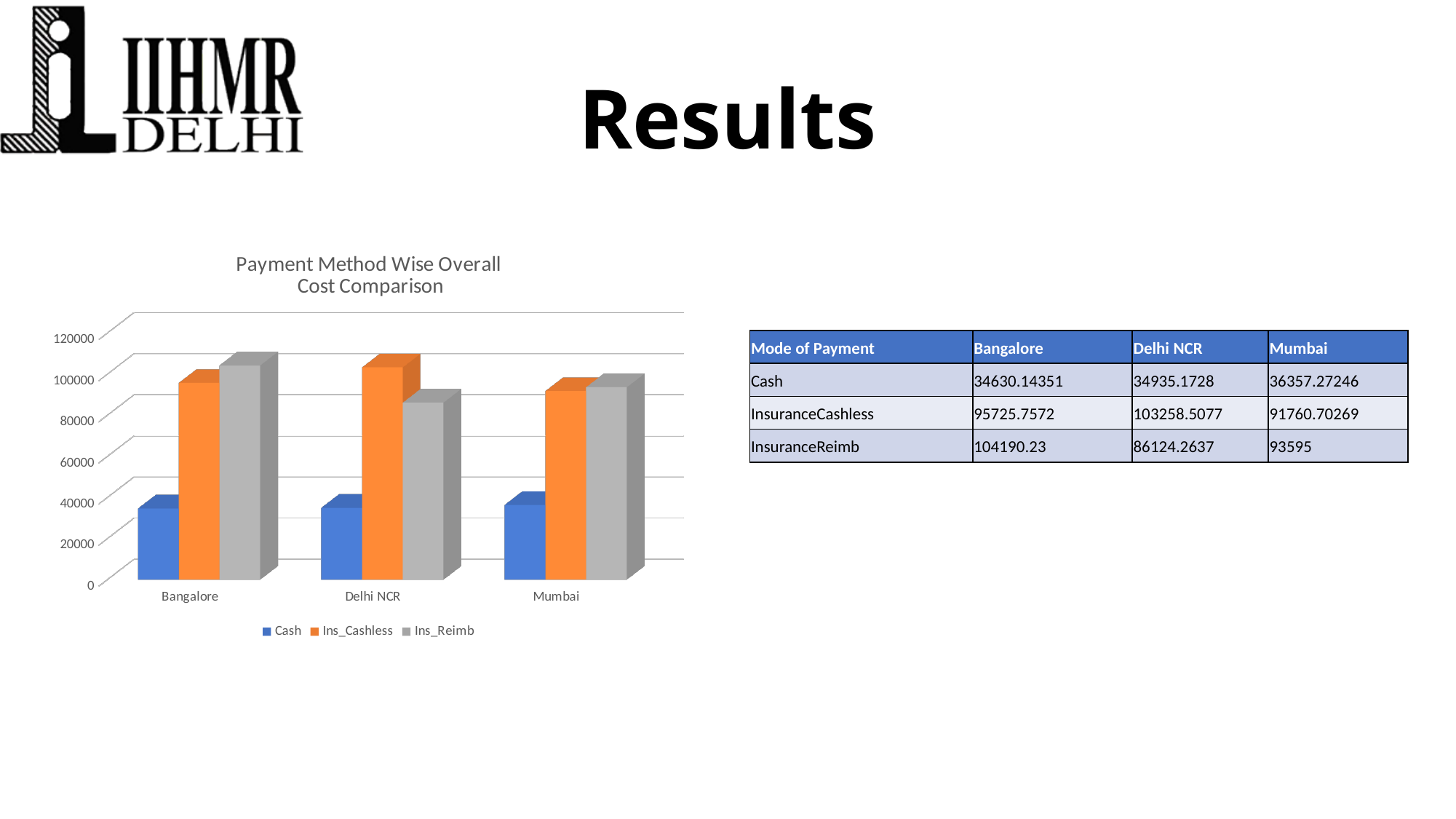
How many cities are shown on the x axis of the chart? 3 Which payment method has the lowest cost in every city in the chart? Cash In Bangalore, which is larger, the Ins_Cashless cost or the Ins_Reimb cost? Ins_Reimb Which city has the highest Ins_Cashless cost in the chart? Delhi NCR What kind of chart is shown on the slide? bar chart Which city has the lowest Ins_Reimb cost in the chart? Delhi NCR Which series is shown in orange in the chart? Ins_Cashless What is the title of the chart? Payment Method Wise Overall Cost Comparison According to the table, what is the InsuranceReimb cost for Mumbai? 93595 How many series does the chart legend list? 3 Is the Cash value for Mumbai greater or less than 40000? less Is the Ins_Cashless value for Delhi NCR greater or less than 100000? greater